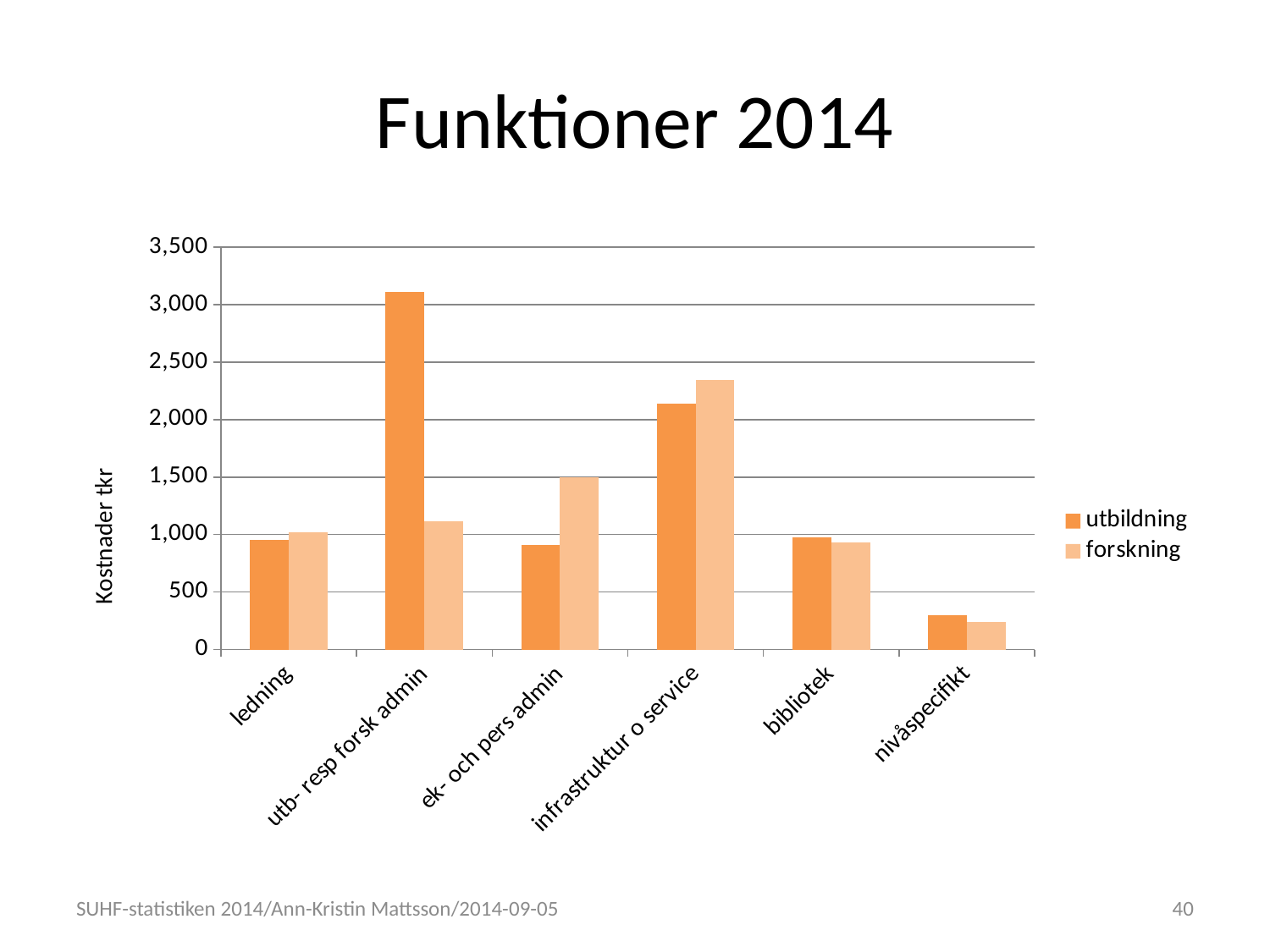
What type of chart is shown on the slide? bar chart Is the utbildning value for nivåspecifikt greater or less than 500? less Which category has the highest forskning value? infrastruktur o service Is the utbildning value for utb- resp forsk admin greater or less than 3,000? greater Which category has the highest utbildning value? utb- resp forsk admin How many categories are shown on the x axis? 6 Which category has the lowest forskning value? nivåspecifikt How many series does the legend list? 2 What is the label of the vertical axis? Kostnader tkr For ek- och pers admin, which is larger: utbildning or forskning? forskning For utb- resp forsk admin, which is larger: utbildning or forskning? utbildning Which category has the lowest utbildning value? nivåspecifikt